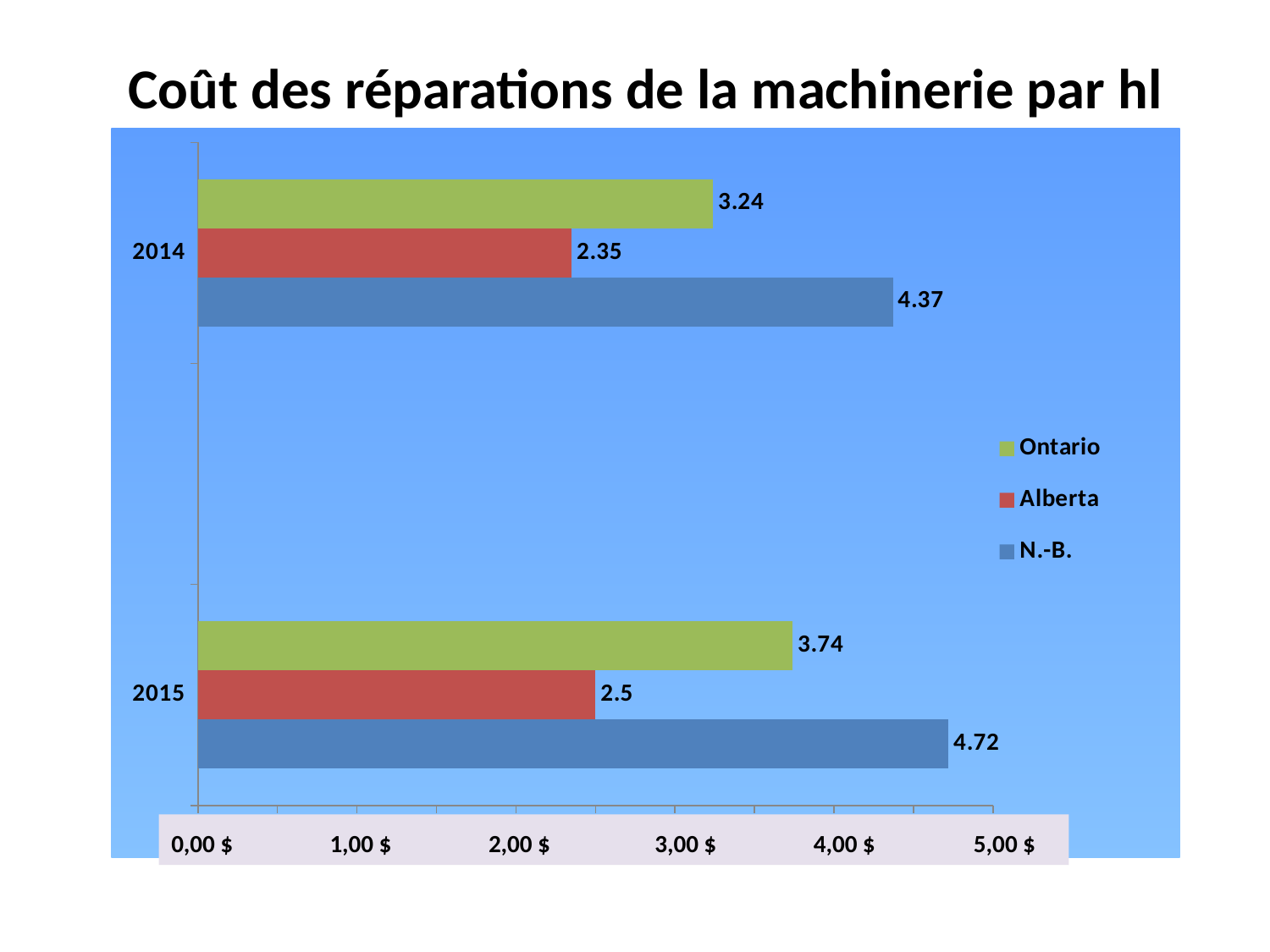
What is the title of the chart? Coût des réparations de la machinerie par hl What kind of chart is shown on the slide? Bar chart What is the difference between the N.-B. value in 2015 and the N.-B. value in 2014? 0.35 What is the value for Alberta in 2014? 2.35 How many series does the legend list? 3 Which is larger, the Ontario value in 2015 or the N.-B. value in 2014? N.-B. value in 2014 Which series has the highest value in 2014? N.-B. What is the difference between the Ontario and Alberta values in 2014? 0.89 What is the value for N.-B. in 2015? 4.72 Which series has the lowest value in 2015? Alberta What is the value for Ontario in 2015? 3.74 How many year categories are shown on the chart? 2